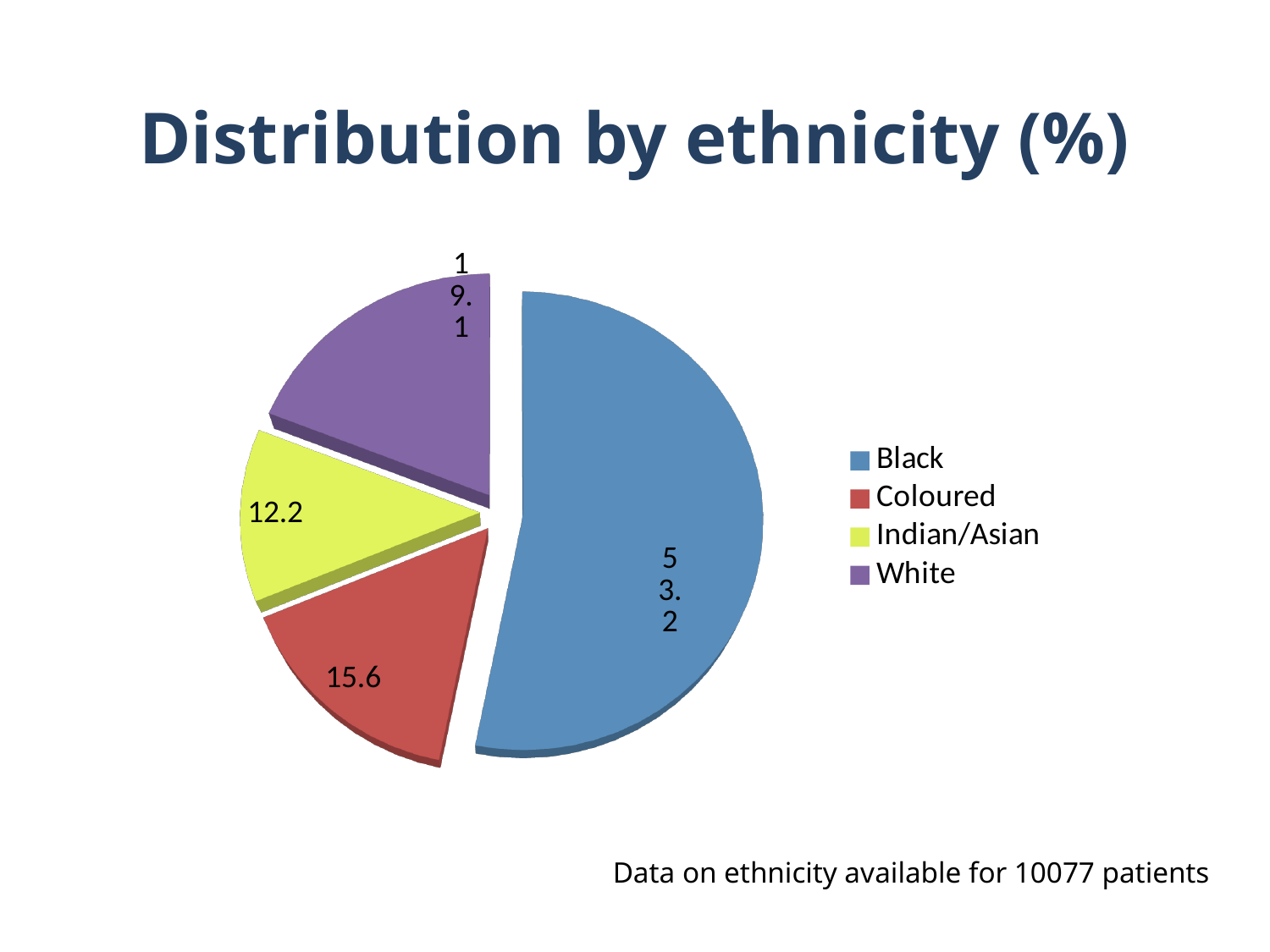
What percentage of patients are White? 19.1 Which colour represents Indian/Asian in the legend? yellow-green What percentage of patients are Black? 53.2 How many ethnicity categories does the pie chart show? 4 What kind of chart is shown on the slide? pie chart What percentage of patients are Indian/Asian? 12.2 Which is larger, the share for Coloured or the share for White? White What is the title of the chart? Distribution by ethnicity (%) Which ethnicity has the smallest share of the pie? Indian/Asian What percentage of patients are Coloured? 15.6 What is the difference between the Black and White percentages? 34.1 Which ethnicity has the largest share of the pie? Black